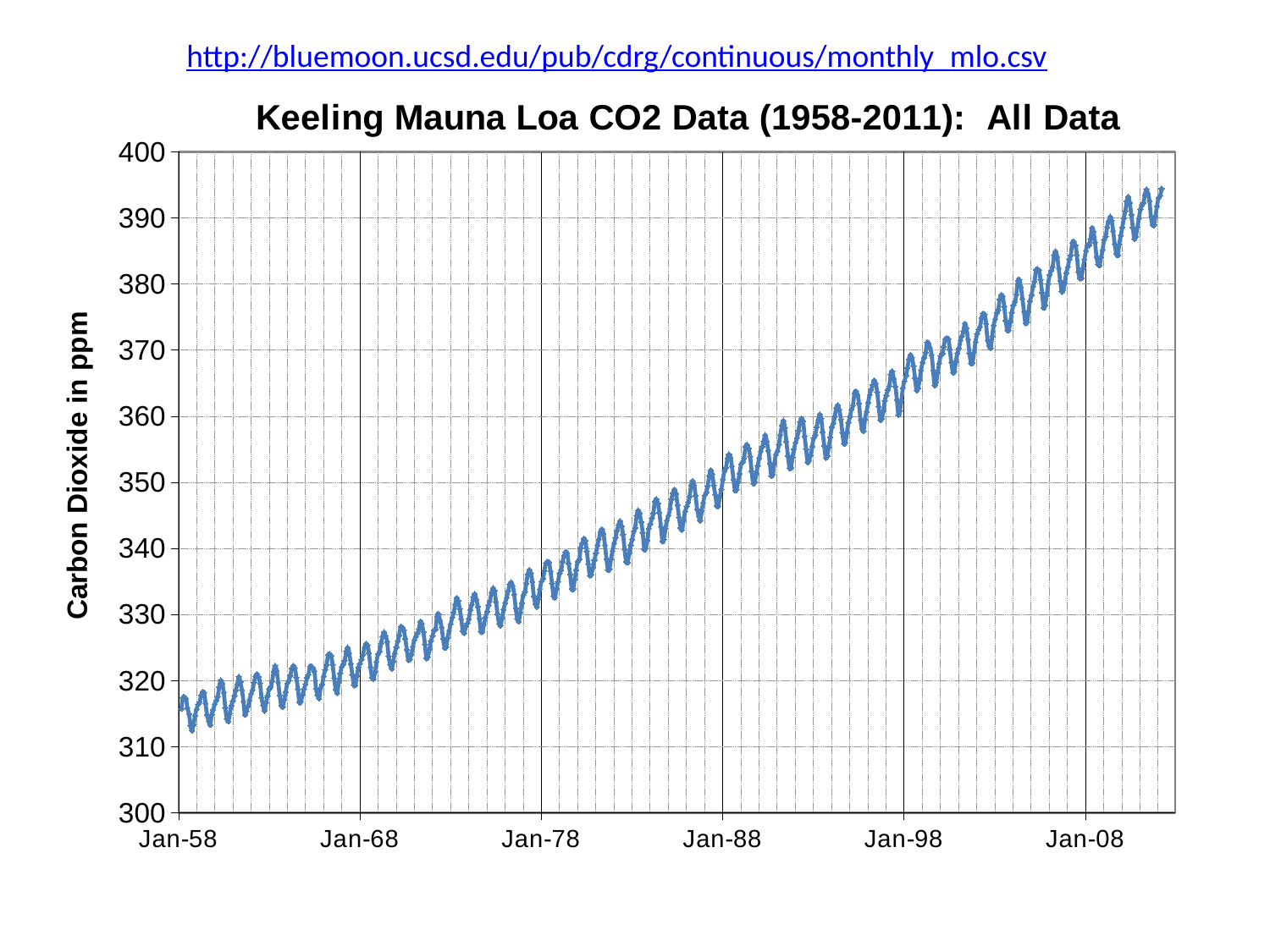
What is the title of the chart? Keeling Mauna Loa CO2 Data (1958-2011): All Data Which is larger, the CO2 value at Jan-88 or at Jan-68? Jan-88 Is the CO2 value at Jan-58 greater or less than 320? less Is the CO2 value at Jan-58 greater or less than 310? greater Is the CO2 value at Jan-68 greater or less than 330? less Do the CO2 values generally rise or fall from Jan-58 to the end of the series? rise What is the label of the vertical axis? Carbon Dioxide in ppm What kind of chart is shown on the slide? line chart